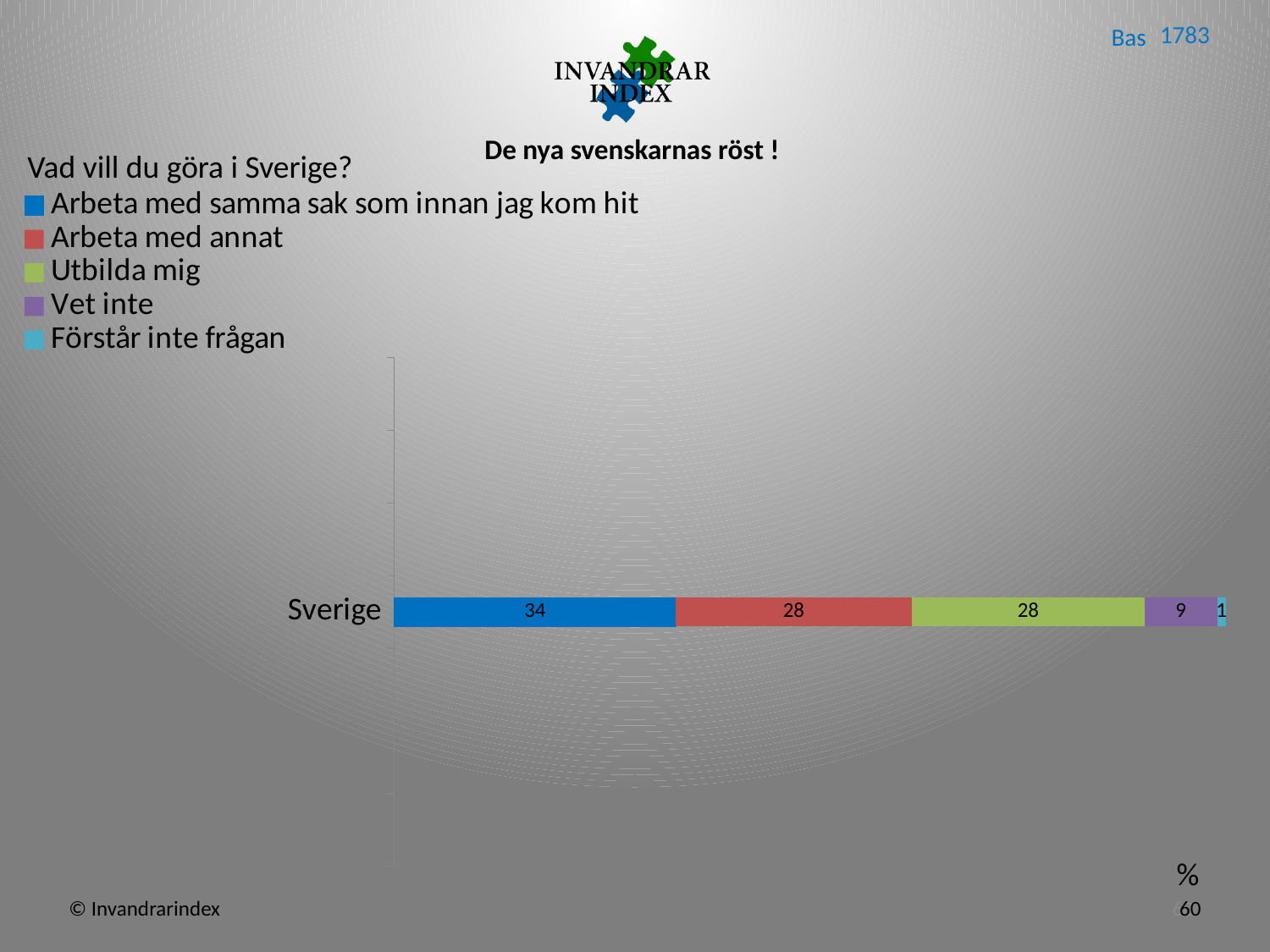
Which series has the smallest segment in the Sverige bar? Förstår inte frågan How many series does the legend list? 5 What is the total of all segments in the Sverige bar? 100 Which series has the largest segment in the Sverige bar? Arbeta med samma sak som innan jag kom hit What kind of chart is shown on the slide? Stacked bar chart What value is shown for 'Förstår inte frågan' in the Sverige bar? 1 What value is shown for 'Arbeta med samma sak som innan jag kom hit' in the Sverige bar? 34 What is the difference between the 'Arbeta med samma sak som innan jag kom hit' segment and the 'Vet inte' segment? 25 Which is larger in the Sverige bar: 'Arbeta med annat' or 'Vet inte'? Arbeta med annat What value is shown for 'Vet inte' in the Sverige bar? 9 What question is the chart about, as stated above the legend? Vad vill du göra i Sverige? What value is shown for 'Utbilda mig' in the Sverige bar? 28